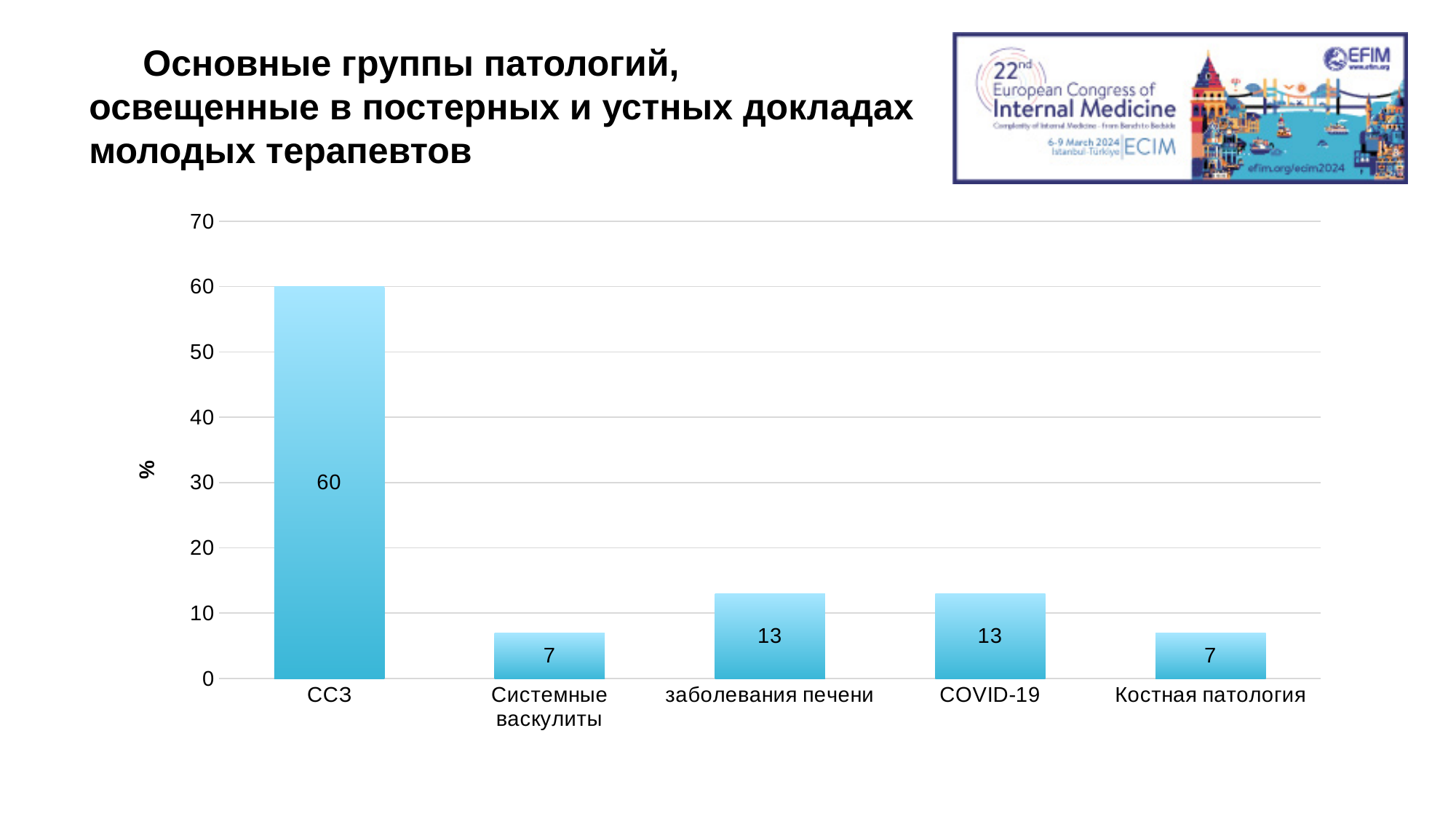
What is the value for Костная патология? 7 What kind of chart is shown on the slide? bar chart What is the difference between the values for заболевания печени and Костная патология? 6 What is the value for Системные васкулиты? 7 How many categories are shown on the x axis? 5 What is the value for ССЗ? 60 What is the value for COVID-19? 13 What is the label of the vertical axis? % What is the value for заболевания печени? 13 What is the difference between the values for ССЗ and COVID-19? 47 Which category has the highest value? ССЗ Which is larger, the value for COVID-19 or the value for Системные васкулиты? COVID-19